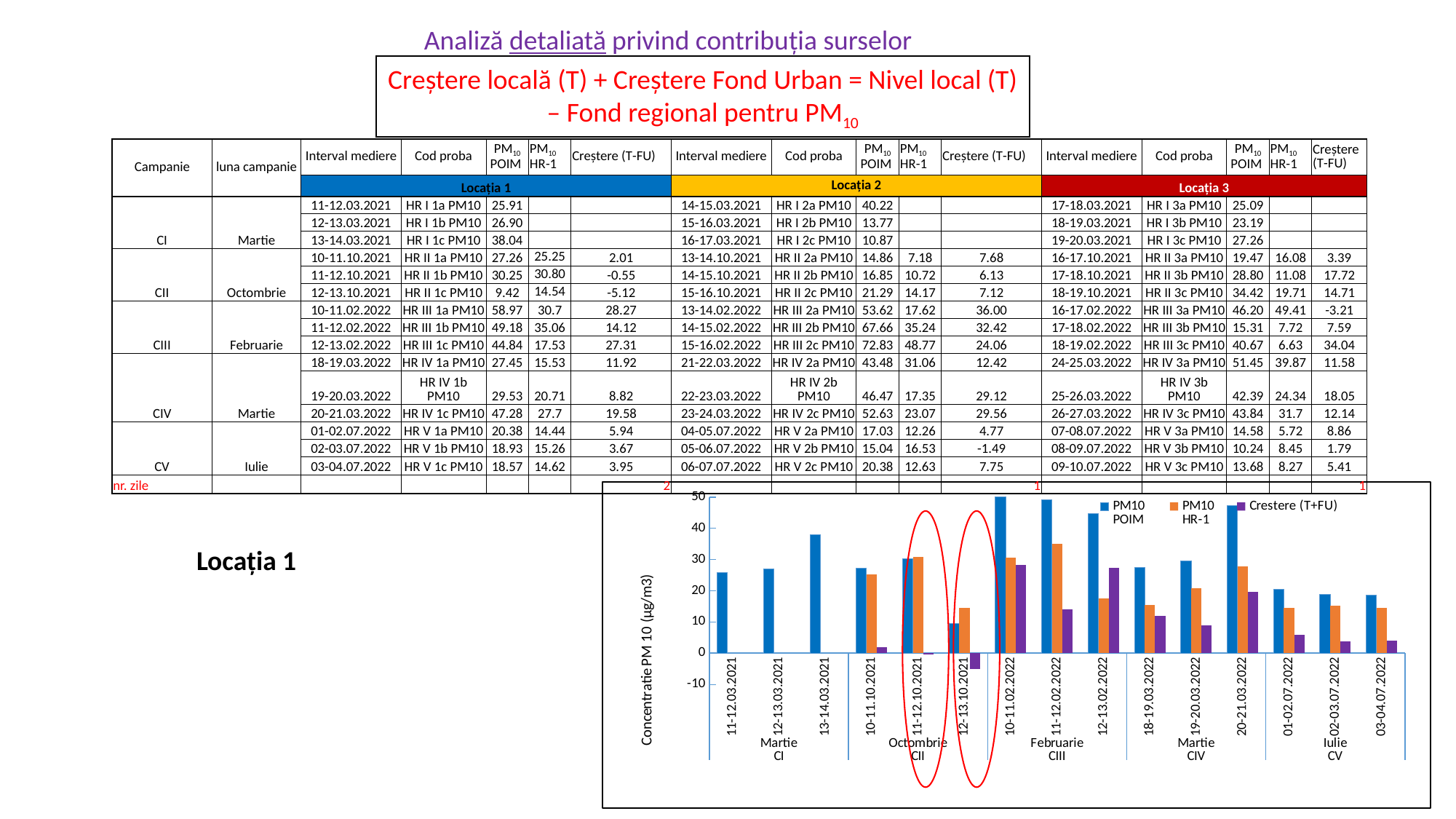
Which date interval has the lowest Crestere (T+FU) value in the chart? 12-13.10.2021 How many campaign groups (CI to CV) are labelled along the x axis of the chart? 5 Is the PM10 POIM value for 12-13.10.2021 greater or less than 20? less What is the label of the vertical axis of the chart? Concentratie PM 10 (µg/m3) Is the Crestere (T+FU) value for 12-13.10.2021 greater or less than 0? less Is the PM10 POIM value for 13-14.03.2021 greater or less than 30? greater How many date intervals are shown along the x axis of the chart? 15 For 11-12.02.2022, which is larger: PM10 POIM or PM10 HR-1? PM10 POIM What kind of chart is shown on the slide? bar chart For 12-13.10.2021, which is larger: PM10 POIM or PM10 HR-1? PM10 HR-1 How many series does the chart legend list? 3